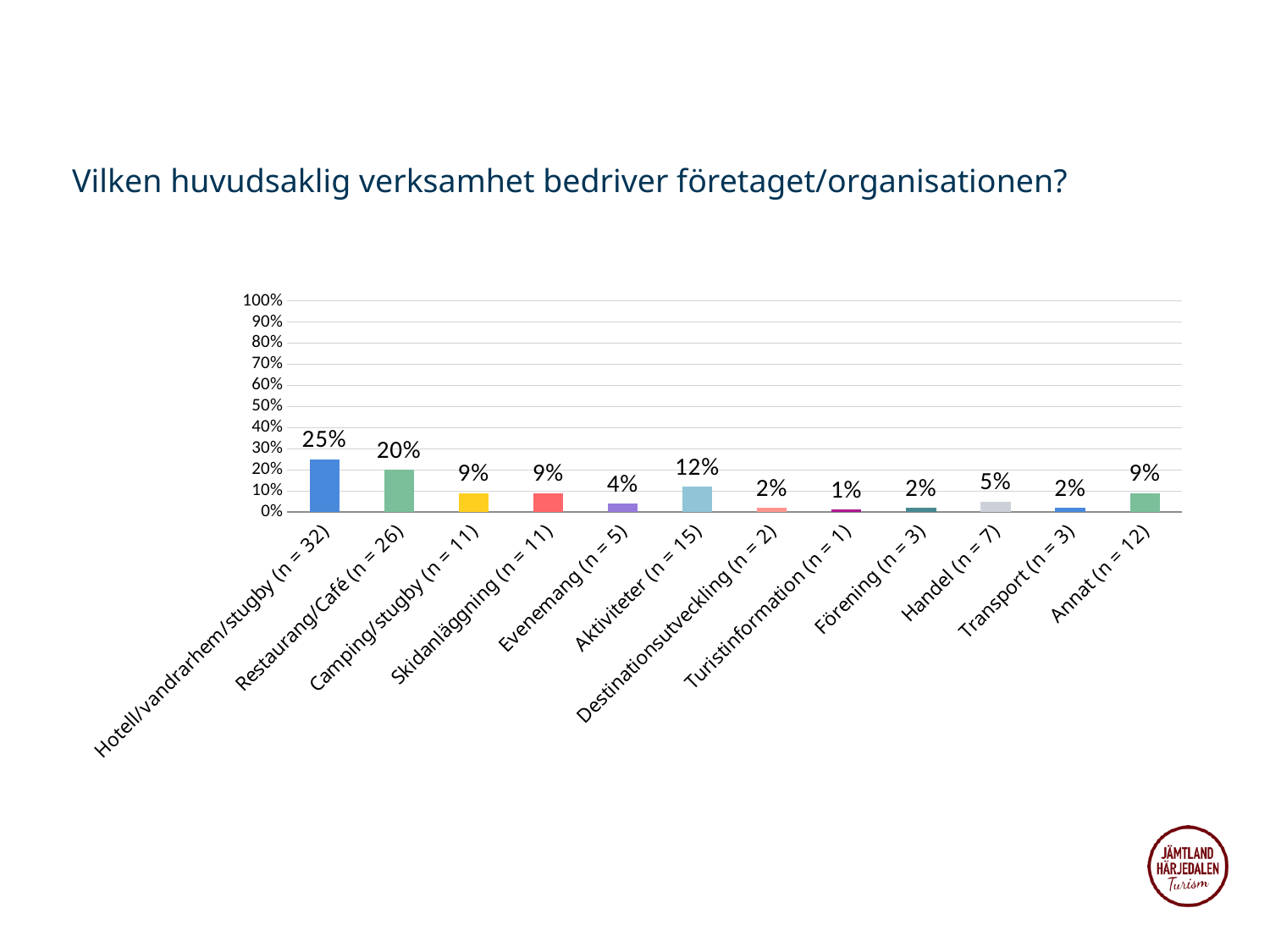
What is the value for Handel (n = 7)? 5% Is the value for Restaurang/Café (n = 26) greater or less than 30%? less Which is larger, the value for Aktiviteter (n = 15) or the value for Annat (n = 12)? Aktiviteter (n = 15) What is the title of the slide? Vilken huvudsaklig verksamhet bedriver företaget/organisationen? How many categories are shown on the x axis? 12 What is the difference between the values for Hotell/vandrarhem/stugby (n = 32) and Restaurang/Café (n = 26)? 5% Which category has the highest value? Hotell/vandrarhem/stugby (n = 32) What is the value for Hotell/vandrarhem/stugby (n = 32)? 25% What kind of chart is shown on the slide? bar chart What is the value for Aktiviteter (n = 15)? 12% What is the value for Evenemang (n = 5)? 4% Which category has the lowest value? Turistinformation (n = 1)